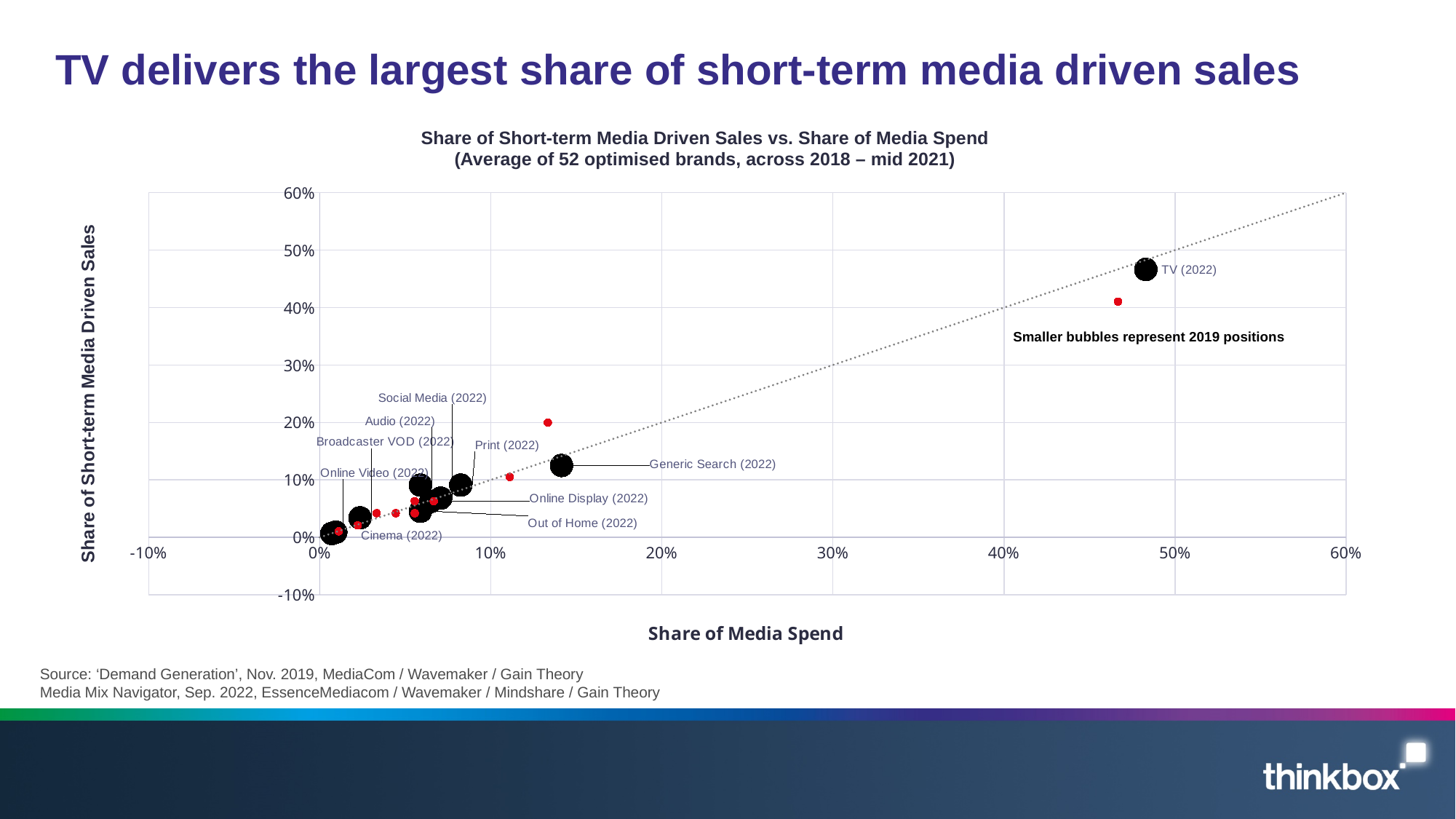
Which labelled 2022 medium has the highest share of short-term media driven sales? TV (2022) What kind of chart is shown on the slide? Scatter (bubble) chart Is the share of short-term media driven sales for Cinema (2022) greater or less than 10%? less Is the share of media spend for TV (2022) greater or less than 40%? greater Is the share of media spend for Generic Search (2022) greater or less than 10%? greater Which has the larger share of short-term media driven sales, TV (2022) or Generic Search (2022)? TV (2022) What is the label of the x axis? Share of Media Spend According to the note on the chart, what do the smaller bubbles represent? 2019 positions How many labelled 2022 media are plotted on the chart? 10